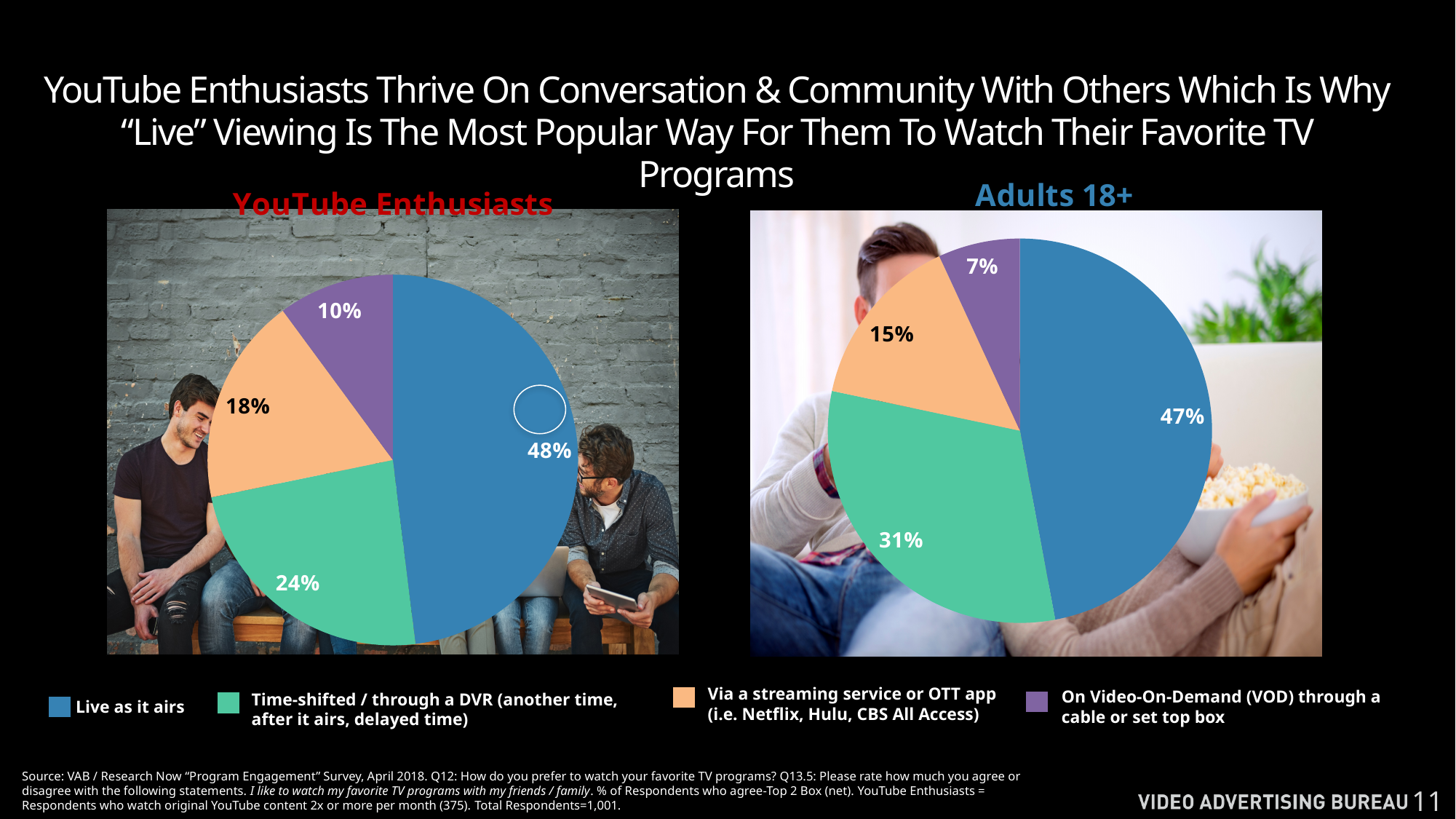
What type of chart is used for the YouTube Enthusiasts data? Pie chart What is the difference between the time-shifted / DVR share for Adults 18+ and for YouTube Enthusiasts? 7 percentage points In the YouTube Enthusiasts pie chart, which viewing method has the largest share? Live as it airs How many entries does the shared legend list? 4 What colour represents 'Live as it airs' in the legend? Blue In the YouTube Enthusiasts pie chart, what share prefer viewing via a streaming service or OTT app? 18% Which group has the larger share for On Video-On-Demand (VOD) through a cable or set top box, YouTube Enthusiasts or Adults 18+? YouTube Enthusiasts How many slices does the Adults 18+ pie chart have? 4 In the Adults 18+ pie chart, which viewing method has the smallest share? On Video-On-Demand (VOD) through a cable or set top box In the YouTube Enthusiasts pie chart, what share of respondents prefer to watch live as it airs? 48% In the Adults 18+ pie chart, what share prefer On Video-On-Demand (VOD) through a cable or set top box? 7% In the Adults 18+ pie chart, what share of respondents prefer time-shifted / through a DVR viewing? 31%